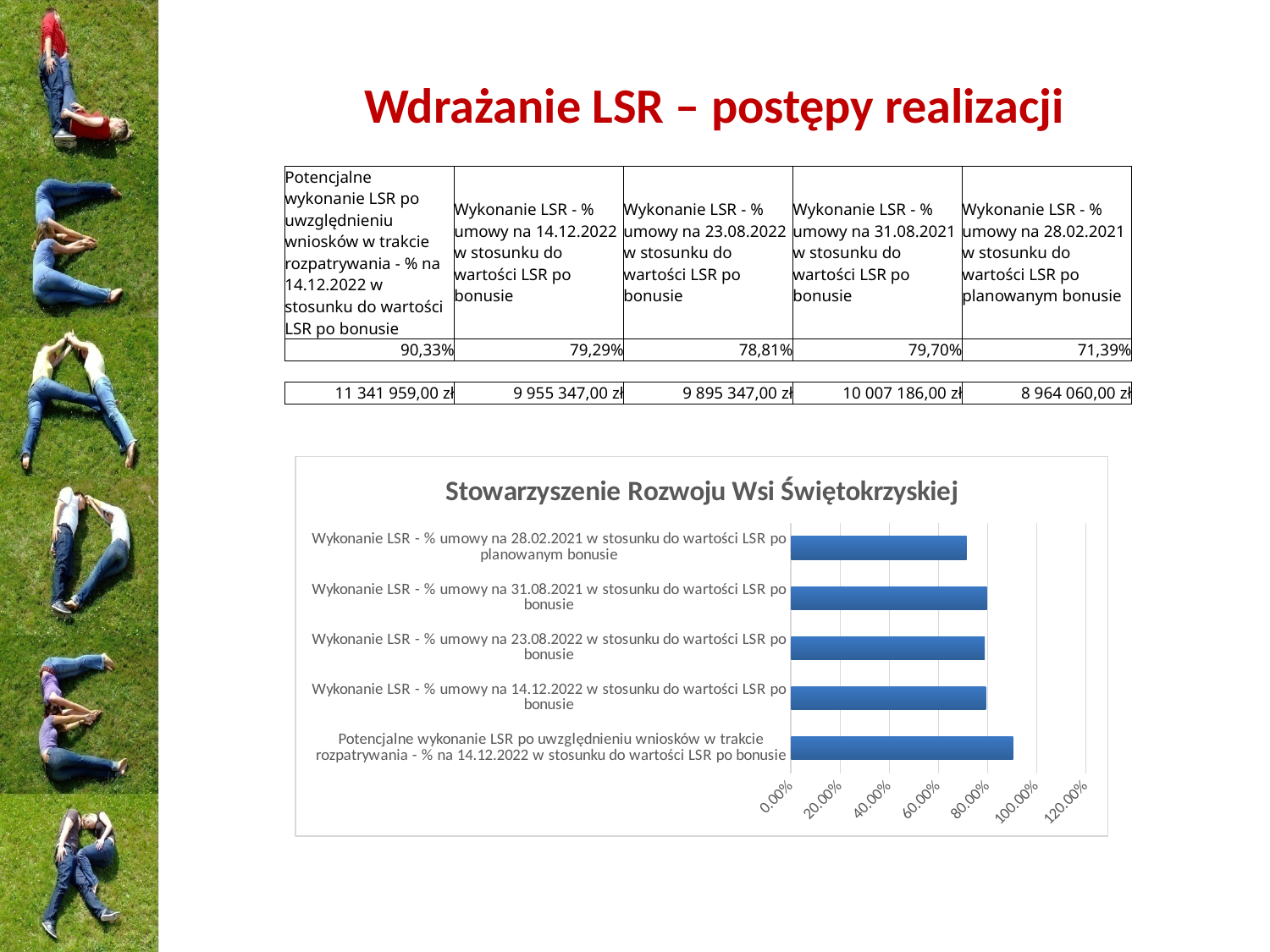
Which category has the shortest bar in the chart? Wykonanie LSR - % umowy na 28.02.2021 w stosunku do wartości LSR po planowanym bonusie According to the table on the slide, what is the value of 'Wykonanie LSR - % umowy na 28.02.2021 w stosunku do wartości LSR po planowanym bonusie'? 71,39% Which is larger: the bar for 'Potencjalne wykonanie LSR ... na 14.12.2022' or the bar for 'Wykonanie LSR - % umowy na 14.12.2022 w stosunku do wartości LSR po bonusie'? Potencjalne wykonanie LSR ... na 14.12.2022 Which category has the longest bar in the chart? Potencjalne wykonanie LSR po uwzględnieniu wniosków w trakcie rozpatrywania - % na 14.12.2022 w stosunku do wartości LSR po bonusie What kind of chart is shown on the slide? bar chart What is the title of the chart? Stowarzyszenie Rozwoju Wsi Świętokrzyskiej How many bars (categories) does the chart show? 5 Is the value for 'Potencjalne wykonanie LSR po uwzględnieniu wniosków w trakcie rozpatrywania' greater or less than 80.00%? greater Is the value for 'Wykonanie LSR - % umowy na 28.02.2021' greater or less than 60.00%? greater According to the table on the slide, what is the value of 'Potencjalne wykonanie LSR po uwzględnieniu wniosków w trakcie rozpatrywania - % na 14.12.2022'? 90,33% Is the value for 'Wykonanie LSR - % umowy na 14.12.2022 w stosunku do wartości LSR po bonusie' greater or less than 100.00%? less